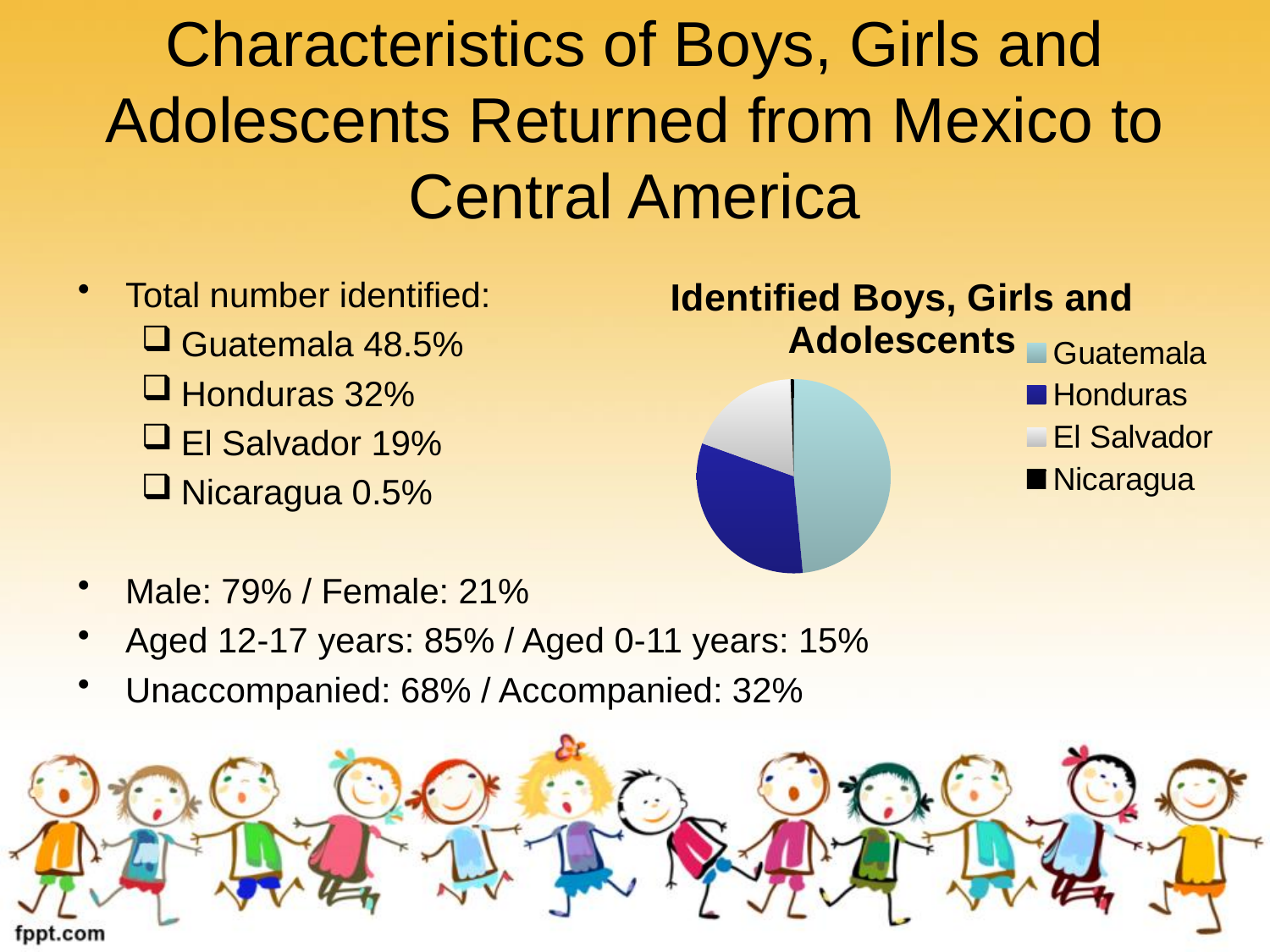
Which slice is larger, Honduras or El Salvador? Honduras Which country has the largest slice of the pie chart? Guatemala Which country is shown in dark blue in the pie chart legend? Honduras How many categories does the legend of the pie chart list? 4 What share of the pie does El Salvador represent? 19% What is the title of the chart? Identified Boys, Girls and Adolescents Which country has the smallest slice of the pie chart? Nicaragua What share of the pie does Honduras represent? 32% What is the difference between the Guatemala share and the Honduras share? 16.5% What kind of chart is shown on the slide? pie chart What share of the pie does Guatemala represent? 48.5%